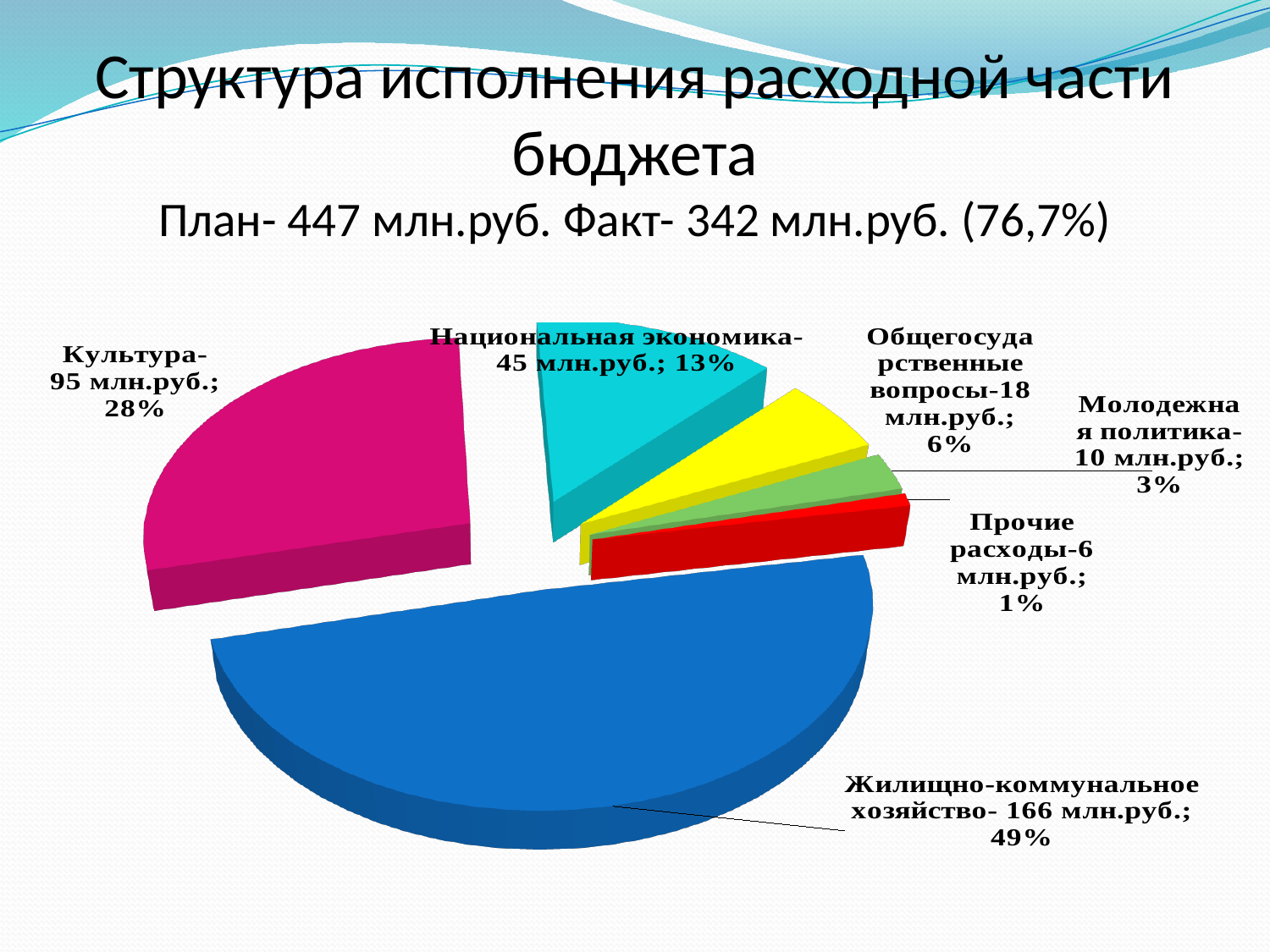
What colour is the slice for Культура? Magenta (pink) What is the value for Жилищно-коммунальное хозяйство? 166 млн.руб. Which is larger, Молодежная политика or Общегосударственные вопросы? Общегосударственные вопросы Which category has the largest slice of the pie? Жилищно-коммунальное хозяйство What kind of chart is shown on the slide? Pie chart How many slices does the pie chart have? 6 What is the difference in млн.руб. between Жилищно-коммунальное хозяйство and Культура? 71 млн.руб. Which category has the smallest slice of the pie? Прочие расходы What share of the pie does Культура represent? 28% What percentage is shown for Общегосударственные вопросы? 6% What is the value for Молодежная политика? 10 млн.руб. What is the value for Национальная экономика? 45 млн.руб.